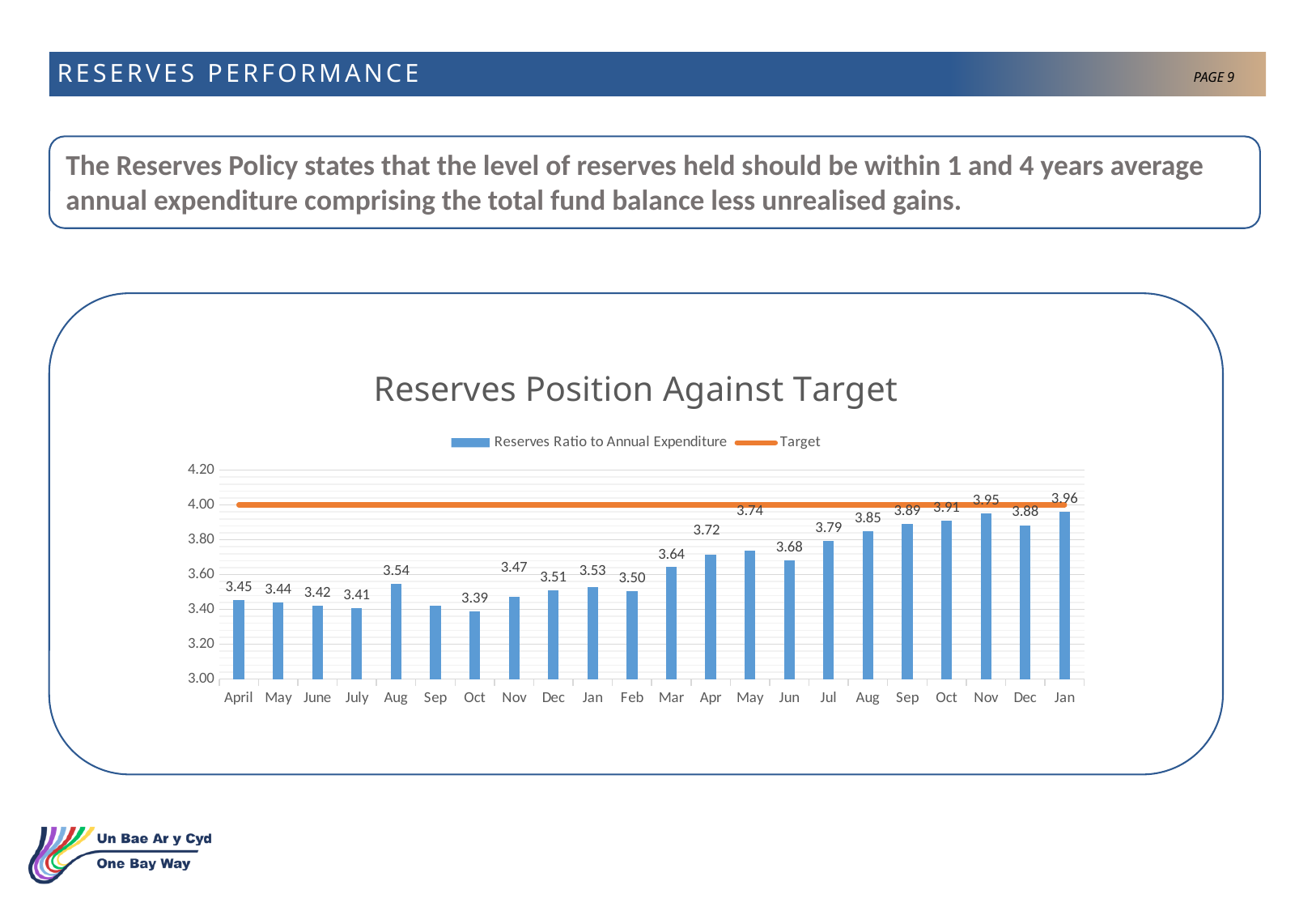
Which month has the lowest Reserves Ratio to Annual Expenditure? Oct (the first Oct on the chart) Is the Reserves Ratio for the first Sep on the chart greater or less than 3.60? less Which is larger, the Reserves Ratio for the first Aug or for the first Nov on the chart? Aug Which month has the highest Reserves Ratio to Annual Expenditure? Jan (the last month on the chart) What is the difference between the Reserves Ratio for Mar and for Feb? 0.14 At what value does the Target line sit on the chart? 4.00 How many months are plotted along the x axis of the chart? 22 Overall, do the Reserves Ratio bars rise or fall from April to the final Jan? rise What is the Reserves Ratio to Annual Expenditure for April, the first month on the chart? 3.45 What kind of chart is shown on the slide? combination bar and line chart (bars with a target line) How many series does the legend of the 'Reserves Position Against Target' chart list? 2 What is the Reserves Ratio to Annual Expenditure for the final month (Jan) on the chart? 3.96